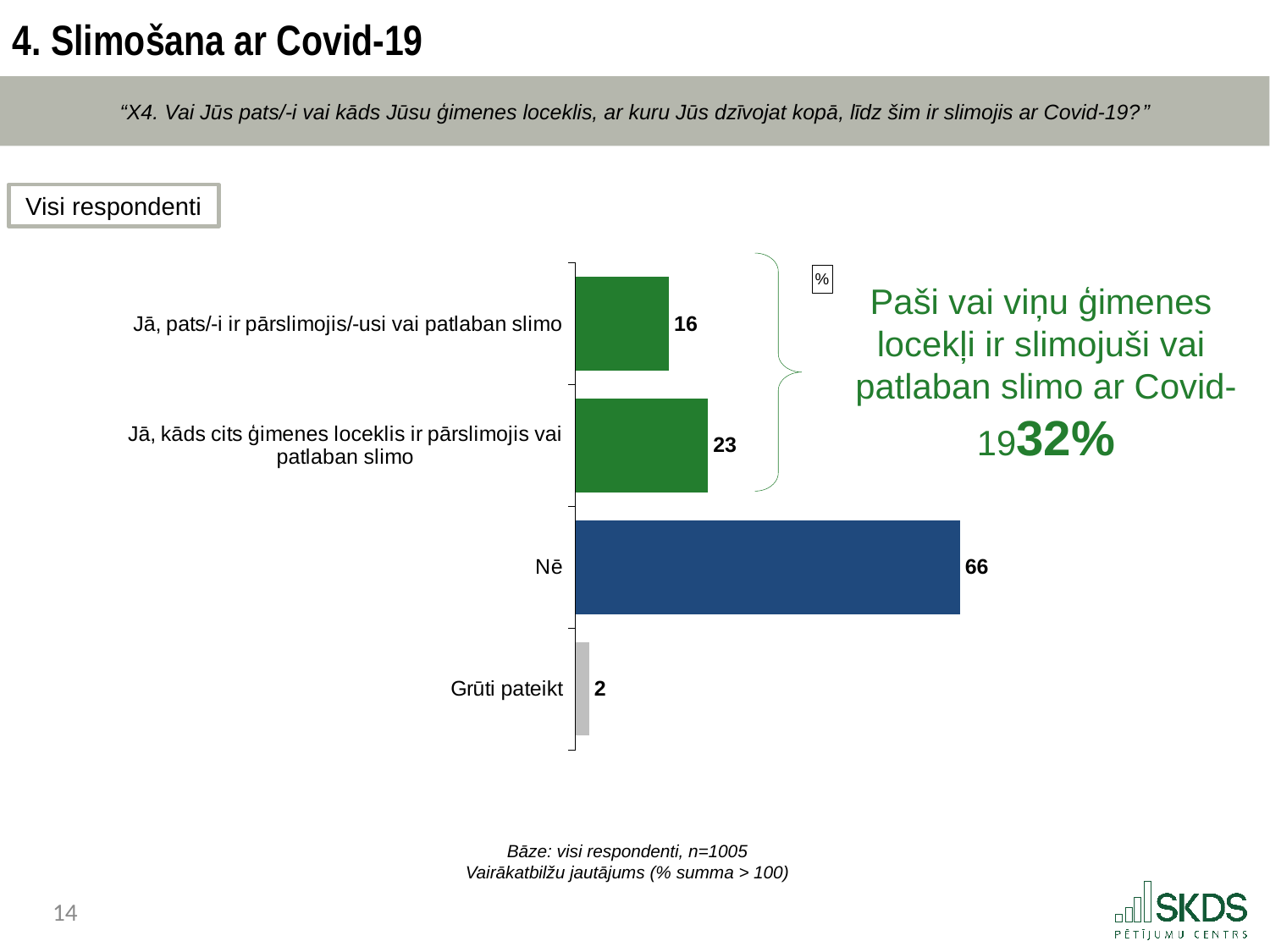
What is the value for "Jā, kāds cits ģimenes loceklis ir pārslimojis vai patlaban slimo"? 23 What is the value for "Nē"? 66 What is the sample size (n) stated in the base note below the chart? n=1005 What is the value for "Grūti pateikt"? 2 Which category has the highest value? Nē What is the difference between the values for "Nē" and "Jā, kāds cits ģimenes loceklis ir pārslimojis vai patlaban slimo"? 43 What kind of chart is shown on the slide? Bar chart Which is larger: the value for "Jā, pats/-i ir pārslimojis/-usi vai patlaban slimo" or for "Jā, kāds cits ģimenes loceklis ir pārslimojis vai patlaban slimo"? Jā, kāds cits ģimenes loceklis ir pārslimojis vai patlaban slimo Which category has the lowest value? Grūti pateikt What is the value for "Jā, pats/-i ir pārslimojis/-usi vai patlaban slimo"? 16 What is the combined value of the two "Jā" categories, as shown in the annotation next to the chart? 32% How many categories are shown in the chart? 4